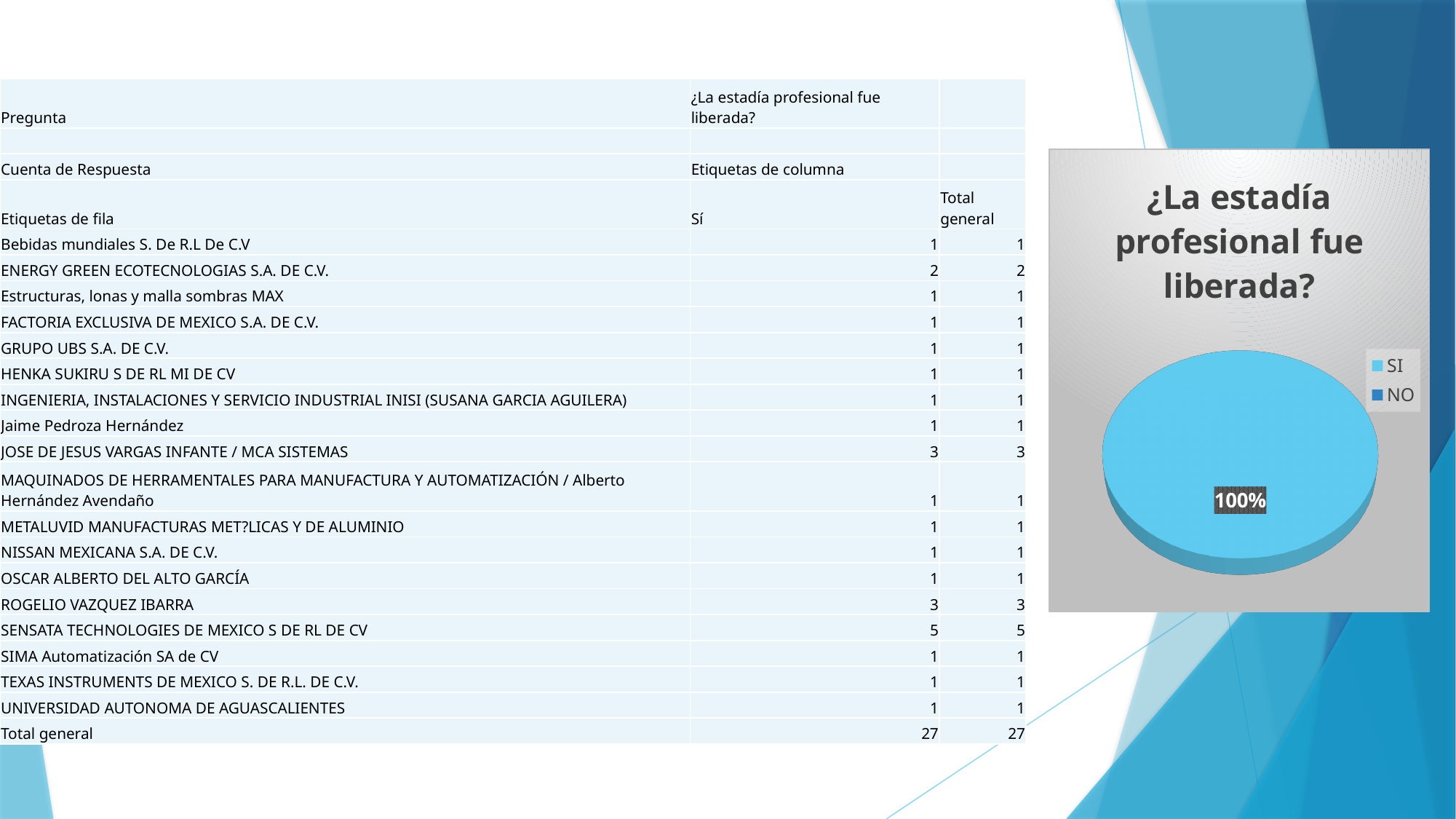
What are the two legend entries of the pie chart? SI and NO How many slices are visibly drawn in the pie chart? 1 How many entries does the pie chart's legend list? 2 Which is larger in the pie chart, SI or NO? SI Which category has the largest slice in the pie chart? SI What share of the pie does the SI slice represent? 100% Which category has the smallest share in the pie chart? NO What is the title of the pie chart? ¿La estadía profesional fue liberada? What kind of chart is shown on the slide? pie chart Is the share for SI greater or less than 50%? greater